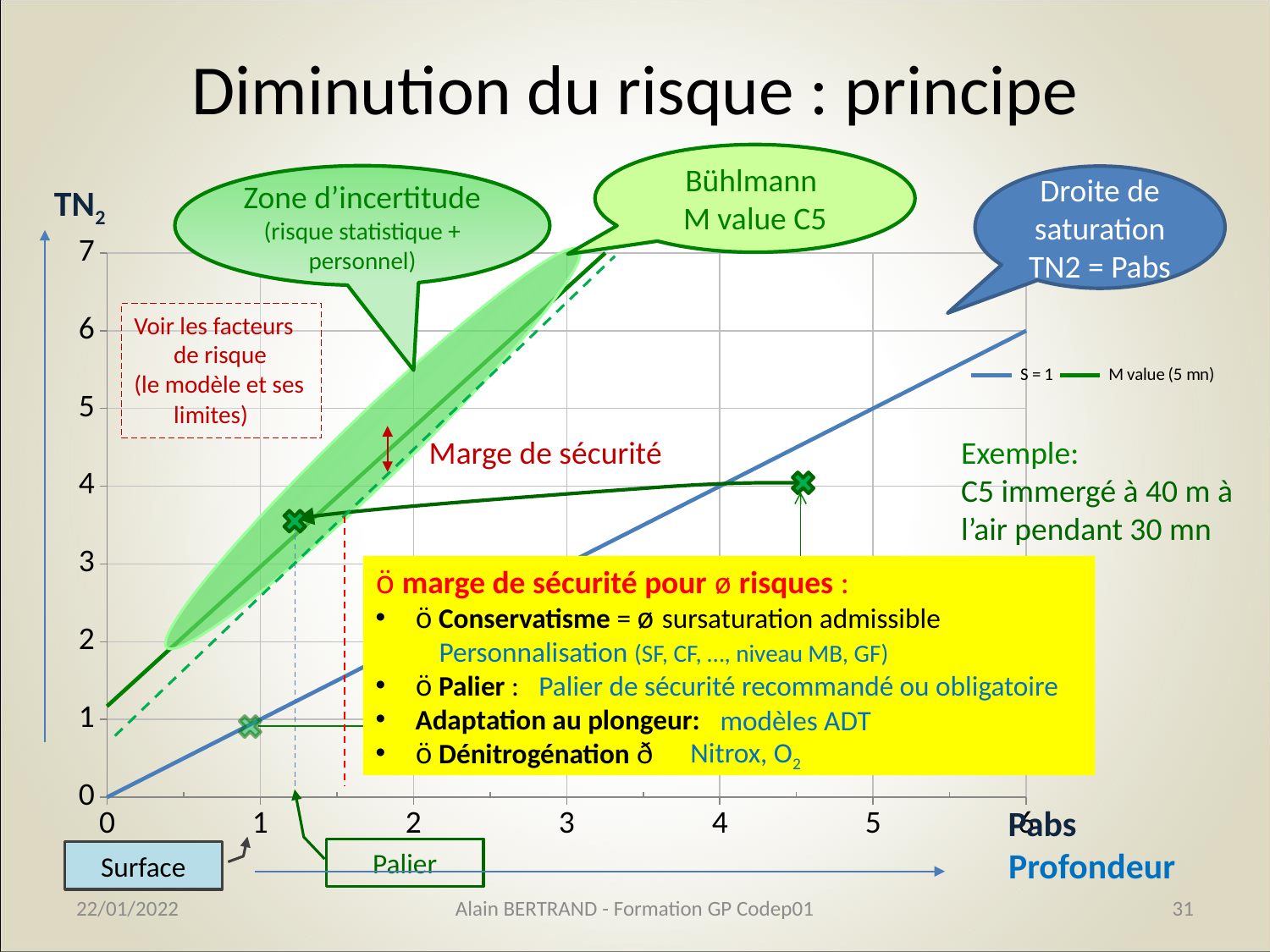
What are the two series named in the chart legend? S = 1 and M value (5 mn) Is the TN2 value of the 'S = 1' line at Pabs = 5 greater or less than 4? greater Does the 'S = 1' line rise or fall as Pabs increases along the x axis? rises What kind of chart is shown on the slide? line chart What is the highest tick value shown on the vertical (TN2) axis of the chart? 7 What is the highest tick value shown on the horizontal (Pabs) axis of the chart? 6 At Pabs = 2, which series has the higher TN2 value, 'S = 1' or 'M value (5 mn)'? M value (5 mn) How many series does the chart legend list? 2 Which colour is used for the 'M value (5 mn)' series in the chart? green Is the TN2 value of the 'S = 1' line at Pabs = 3 greater or less than 4? less Is the TN2 value of the 'M value (5 mn)' line at Pabs = 2 greater or less than 4? greater Does the 'M value (5 mn)' line rise or fall as Pabs increases along the x axis? rises